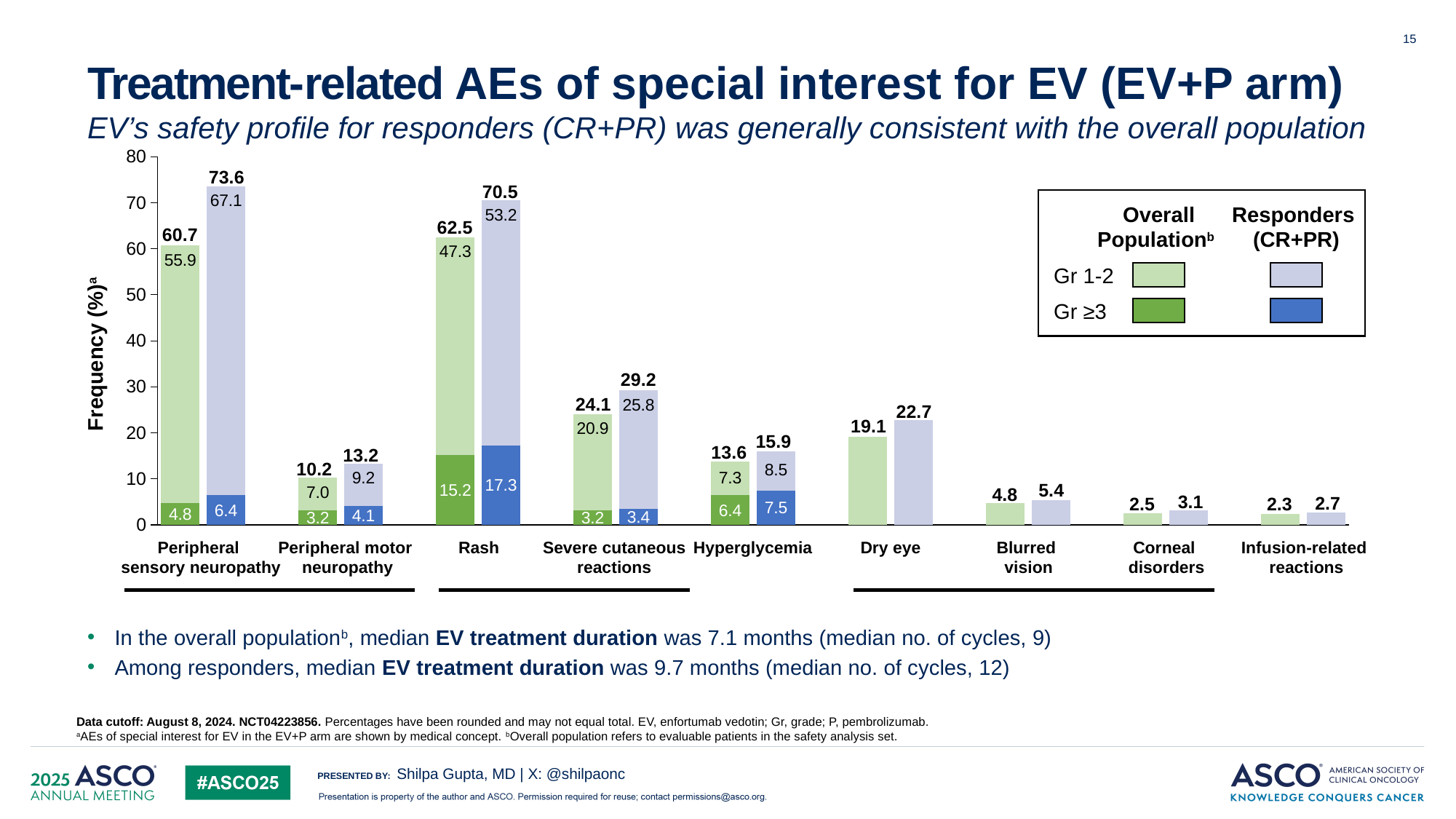
What is the total frequency of Rash among Responders (CR+PR)? 70.5 Is the total frequency of Blurred vision among Responders (CR+PR) greater or less than 10? less How many adverse event categories are shown on the x axis? 9 For Dry eye, which group has the higher frequency: the Overall Population or Responders (CR+PR)? Responders (CR+PR) What is the label of the y axis? Frequency (%) What is the difference between the Gr ≥3 frequency of Peripheral sensory neuropathy among Responders (CR+PR) and in the Overall Population? 1.6 Which adverse event has the highest total frequency among Responders (CR+PR)? Peripheral sensory neuropathy What is the difference between the total frequency of Rash among Responders (CR+PR) and in the Overall Population? 8.0 Which adverse event has the lowest total frequency in the Overall Population? Infusion-related reactions What is the Gr 1-2 frequency of Hyperglycemia among Responders (CR+PR)? 8.5 What kind of chart is shown on the slide? Bar chart What is the Gr ≥3 frequency of Peripheral sensory neuropathy in the Overall Population? 4.8